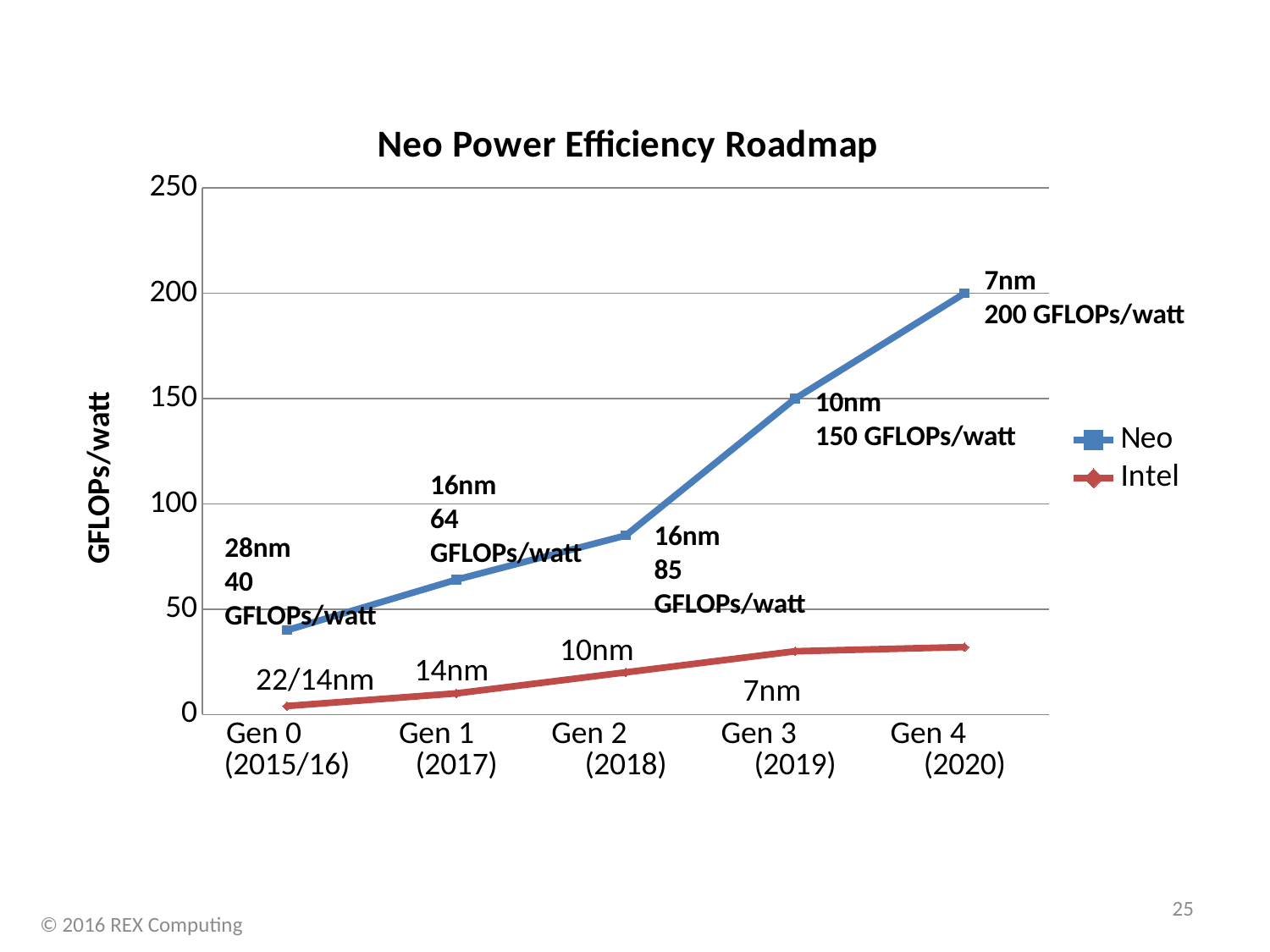
Is the Intel value at Gen 4 (2020) greater or less than 50? less How many series does the legend list? 2 What is the Neo value at Gen 2 (2018)? 85 GFLOPs/watt At which generation does the Neo series reach its highest value? Gen 4 (2020) What is the Neo value at Gen 0 (2015/16)? 40 GFLOPs/watt Does the Neo series rise or fall from Gen 0 to Gen 4? rise What is the Neo value at Gen 4 (2020)? 200 GFLOPs/watt What is the difference between the Neo values at Gen 3 (2019) and Gen 1 (2017)? 86 GFLOPs/watt How many generations are plotted along the x axis? 5 What is the title of the chart? Neo Power Efficiency Roadmap What kind of chart is shown on the slide? line chart Which series is higher at Gen 3 (2019), Neo or Intel? Neo